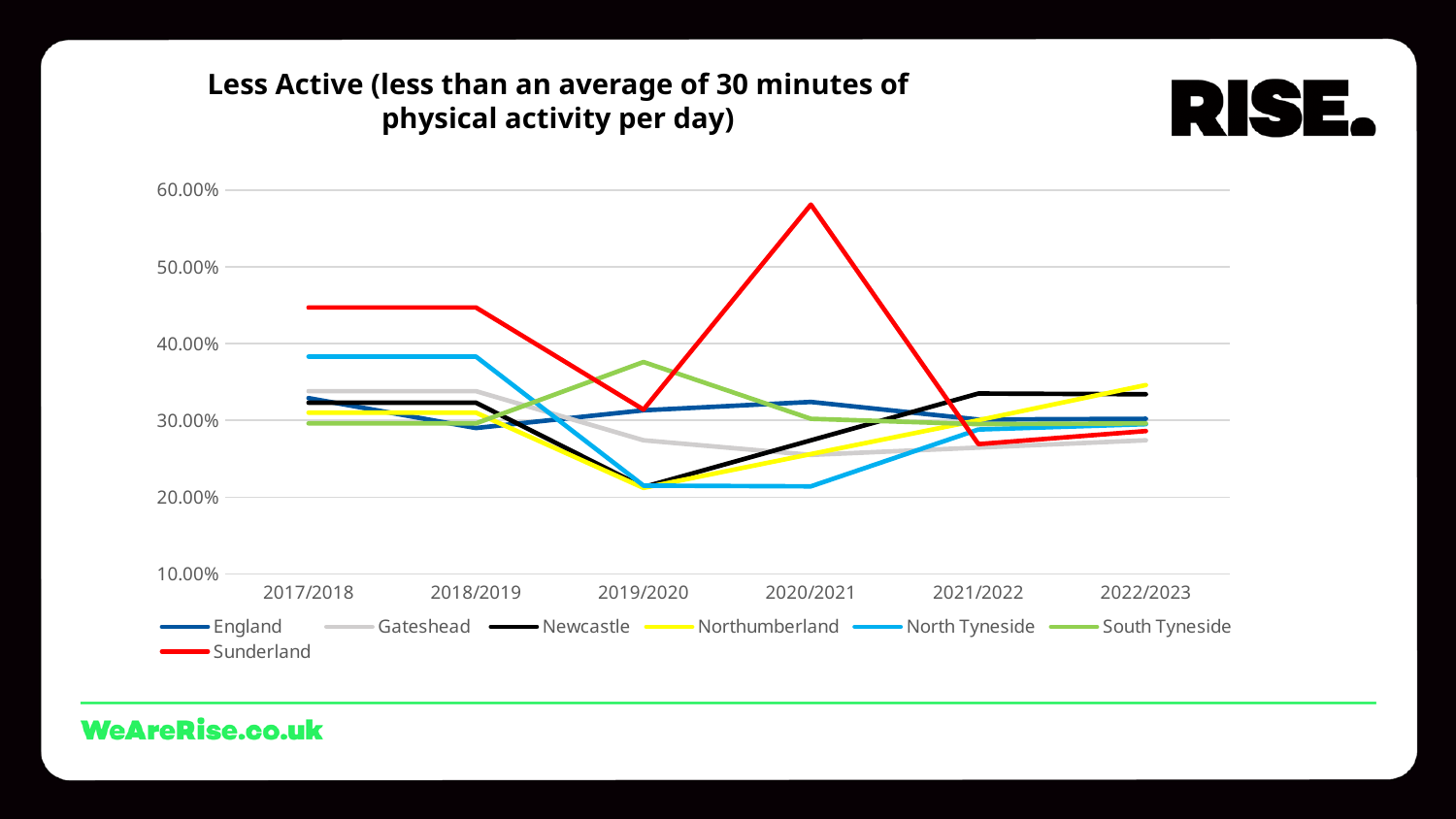
How many time periods are shown along the x axis? 6 Is the value for Sunderland in 2020/2021 greater or less than 50.00%? greater How many series does the legend list? 7 What colour is the Sunderland line in the chart? Red What kind of chart is shown on the slide? Line chart In 2020/2021, which is larger: the value for Sunderland or the value for North Tyneside? Sunderland Is the value for North Tyneside in 2019/2020 greater or less than 30.00%? less Which area has the highest value in 2017/2018? Sunderland Does the Gateshead line rise or fall from 2017/2018 to 2019/2020? Falls Which area has the highest value in 2020/2021? Sunderland Which area has the lowest value in 2020/2021? North Tyneside Which area has the highest value in 2019/2020? South Tyneside